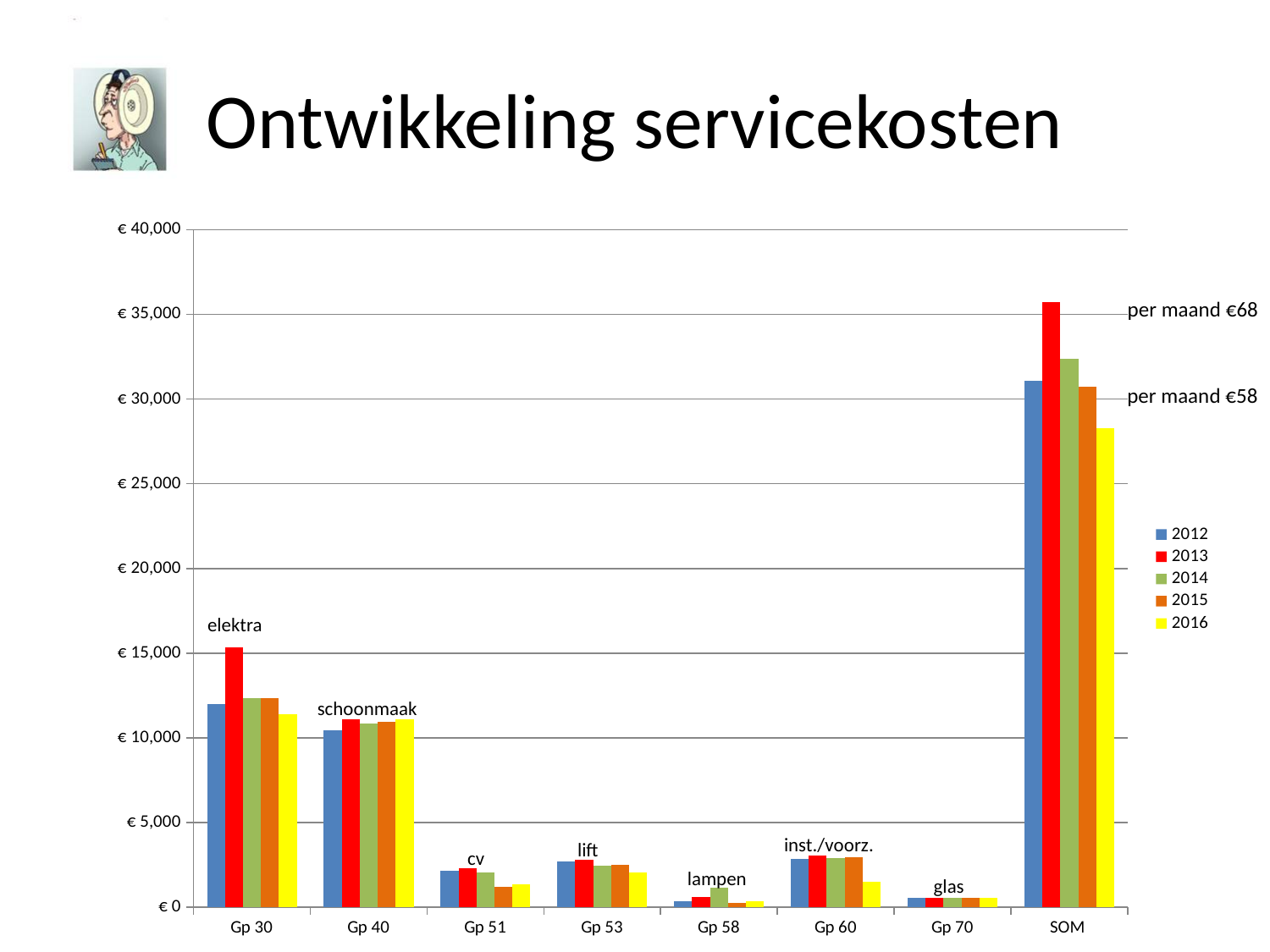
How many categories are shown on the x axis of the chart? 8 Is the value for SOM in 2016 greater or less than 30,000? less From 2013 to 2016, do the values for SOM rise or fall? fall Which year has the highest value for SOM? 2013 Which is larger, the 2013 value for Gp 30 or the 2013 value for Gp 40? Gp 30 Is the value for Gp 30 in 2012 greater or less than 10,000? greater What kind of chart is shown on the slide? bar chart Is the value for SOM in 2013 greater or less than 35,000? greater Which year has the highest value for Gp 30? 2013 Which year has the lowest value for SOM? 2016 What label is written above the bars for Gp 40? schoonmaak How many series does the legend list? 5